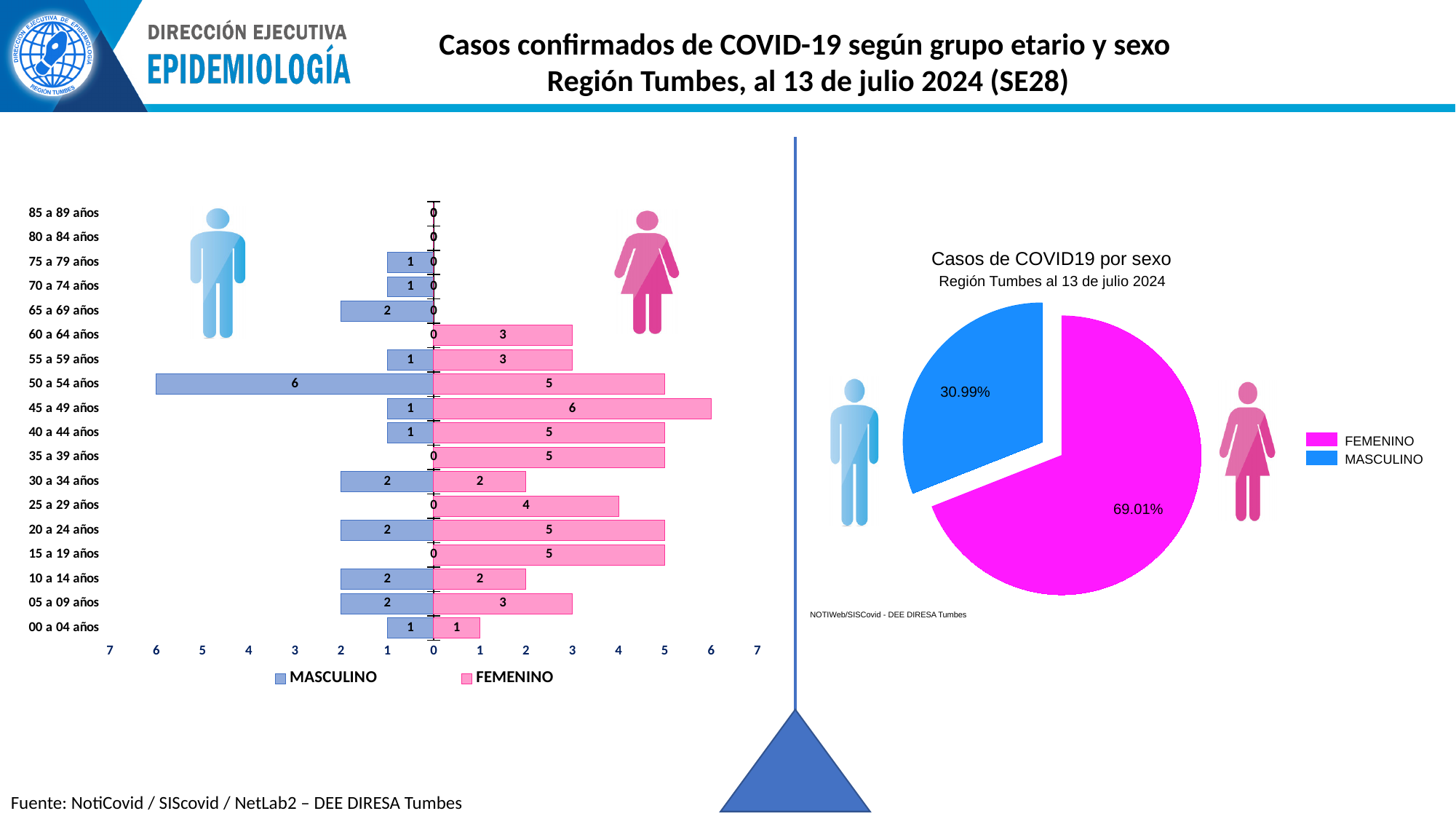
In the left chart (cases by age group and sex), which age group has the highest FEMENINO value? 45 a 49 años In the pie chart 'Casos de COVID19 por sexo', what share of cases is MASCULINO? 30.99% In the left chart (cases by age group and sex), what is the difference between the FEMENINO and MASCULINO values for the 20 a 24 años group? 3 What kind of chart is the left chart (cases by age group and sex)? Bar chart In the left chart (cases by age group and sex), how many age groups are shown? 18 In the left chart (cases by age group and sex), what is the MASCULINO value for the 50 a 54 años group? 6 In the left chart (cases by age group and sex), which is larger for the 65 a 69 años group, MASCULINO or FEMENINO? MASCULINO In the left chart (cases by age group and sex), what is the FEMENINO value for the 25 a 29 años group? 4 In the left chart (cases by age group and sex), what is the FEMENINO value for the 45 a 49 años group? 6 In the left chart (cases by age group and sex), which age group has the highest MASCULINO value? 50 a 54 años In the pie chart 'Casos de COVID19 por sexo', what share of cases is FEMENINO? 69.01% In the left chart (cases by age group and sex), how many series does the legend list? 2